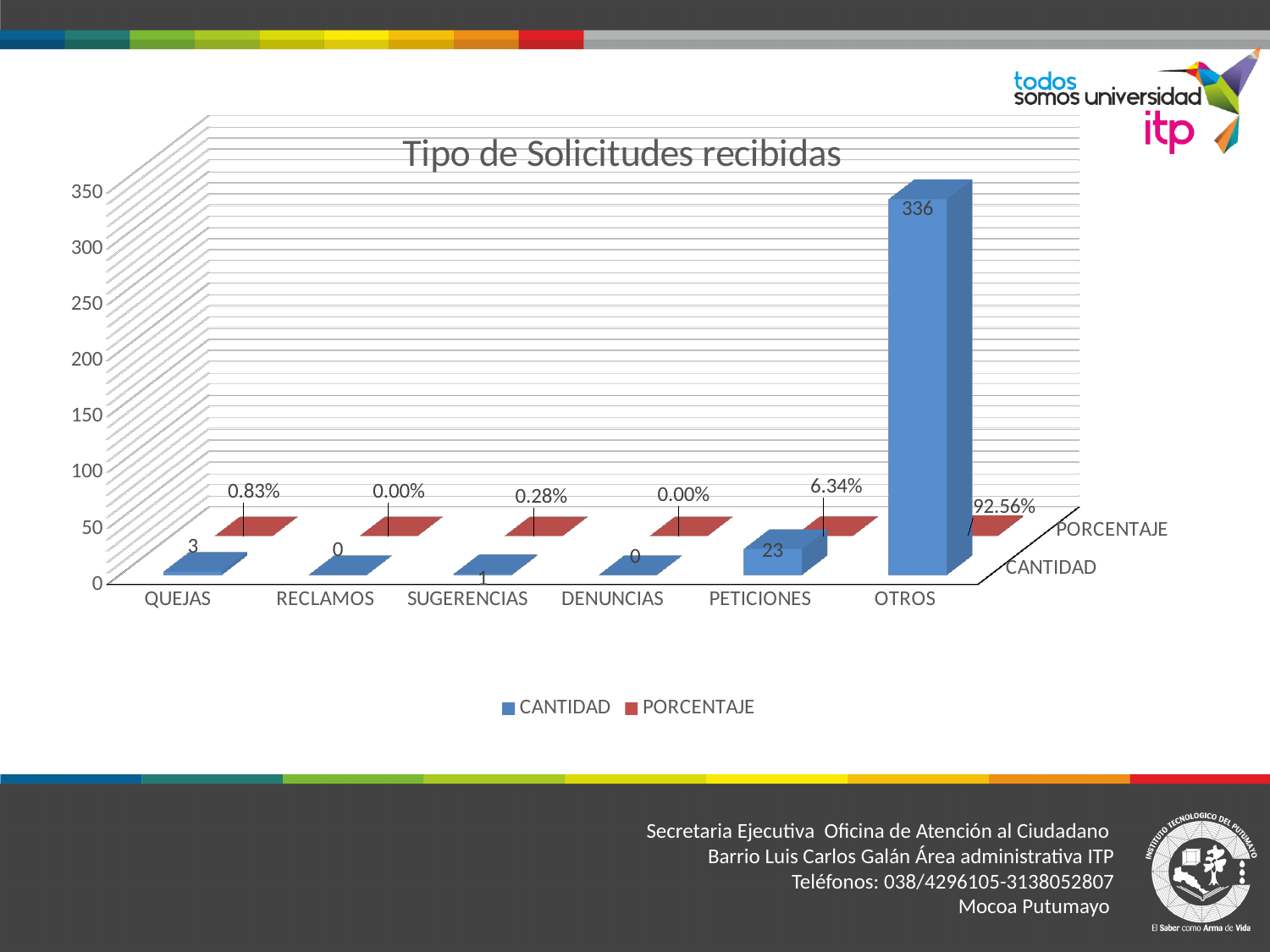
What is the CANTIDAD value for PETICIONES? 23 What is the PORCENTAJE value for PETICIONES? 6.34% Is the CANTIDAD value for OTROS greater or less than 300? greater What is the PORCENTAJE value for OTROS? 92.56% What is the CANTIDAD value for OTROS? 336 Which has a larger CANTIDAD value, QUEJAS or PETICIONES? PETICIONES Which category has the highest CANTIDAD value? OTROS How many series does the legend list? 2 How many categories are shown on the x axis? 6 What is the difference in CANTIDAD between OTROS and PETICIONES? 313 What is the PORCENTAJE value for QUEJAS? 0.83% What is the title of the chart? Tipo de Solicitudes recibidas